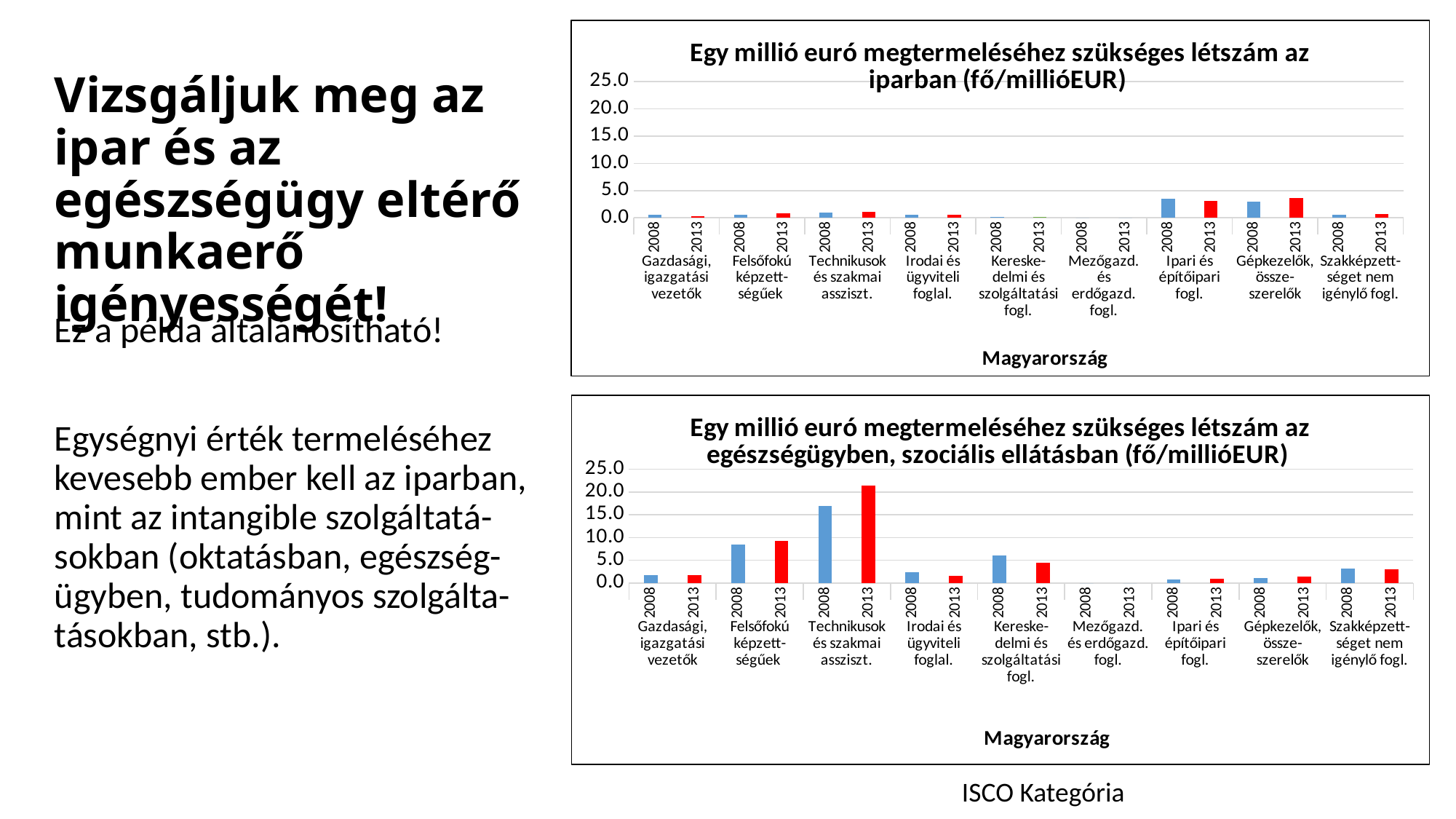
What unit is given in the title of the bottom chart? fő/millióEUR In the bottom chart (egészségügyben, szociális ellátásban), is the 2008 value for Technikusok és szakmai assziszt. greater or less than 20.0? less What country label appears below the x axis of both charts? Magyarország In the bottom chart (egészségügyben, szociális ellátásban), which year has the larger value for Kereskedelmi és szolgáltatási fogl., 2008 or 2013? 2008 In the top chart (iparban), which year has the larger value for Gépkezelők, összeszerelők, 2008 or 2013? 2013 What kind of chart is the top chart, 'Egy millió euró megtermeléséhez szükséges létszám az iparban'? bar chart In the bottom chart (egészségügyben, szociális ellátásban), is the 2013 value for Felsőfokú képzettségűek greater or less than 10.0? less In the top chart (iparban), which occupation category has the lowest values in both years? Mezőgazd. és erdőgazd. fogl. In the bottom chart (egészségügyben, szociális ellátásban), which bar is the highest? Technikusok és szakmai assziszt., 2013 In the top chart (iparban), is the 2008 value for Ipari és építőipari fogl. greater or less than 5.0? less In the bottom chart (egészségügyben, szociális ellátásban), how many occupation categories are shown on the x axis? 9